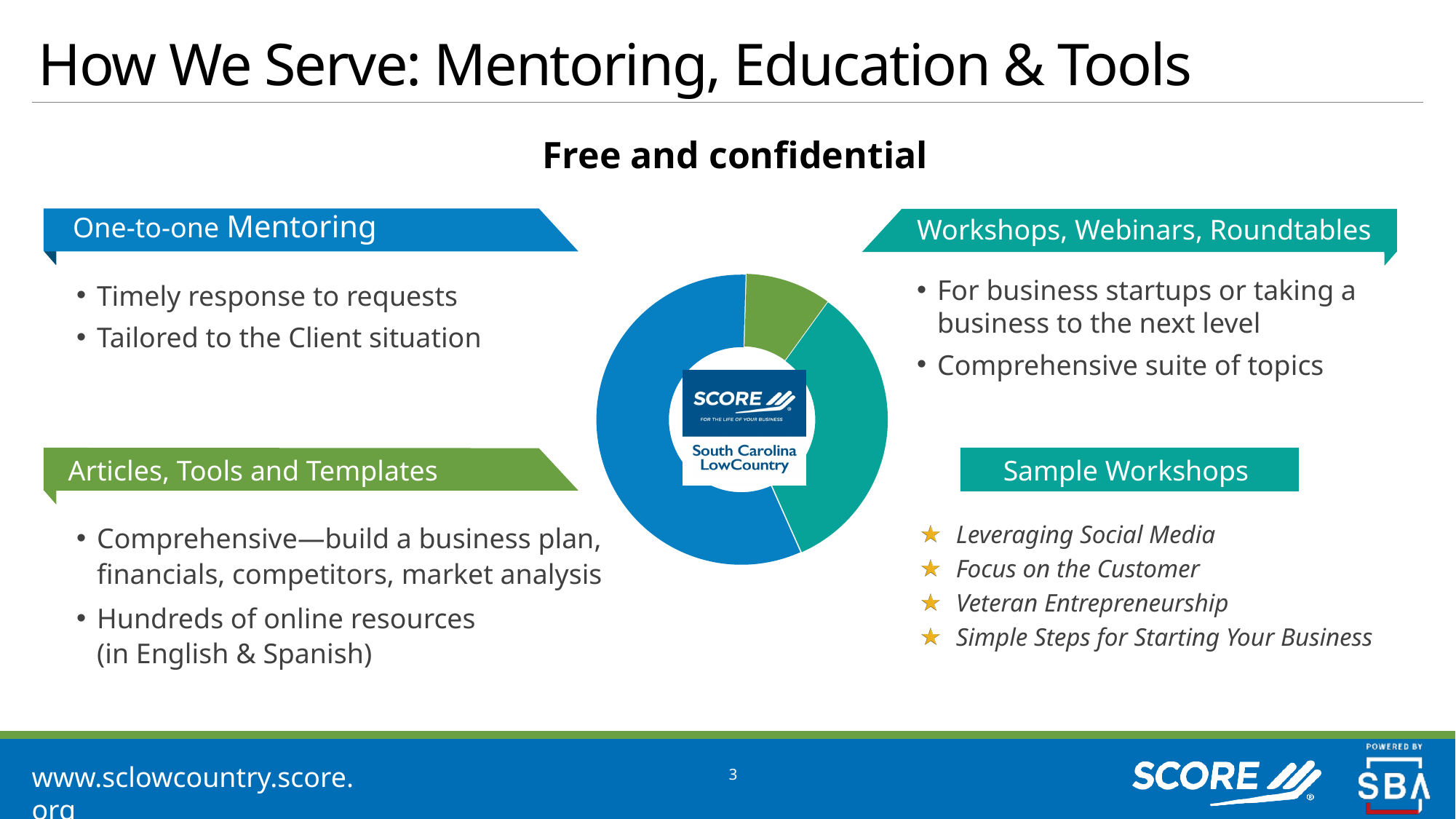
Does the blue slice of the donut chart take up more or less than half of the chart? More In the donut chart, is the blue slice larger or smaller than the teal slice? Larger Which colour slice is the smallest in the donut chart? Green What kind of chart is shown in the centre of the slide? Pie chart (donut) Does the donut chart display a legend? No In the donut chart, is the green slice larger or smaller than the teal slice? Smaller How many slices does the donut chart in the centre of the slide have? 3 Which colour slice is the largest in the donut chart? Blue What logo appears in the centre hole of the donut chart? SCORE South Carolina LowCountry